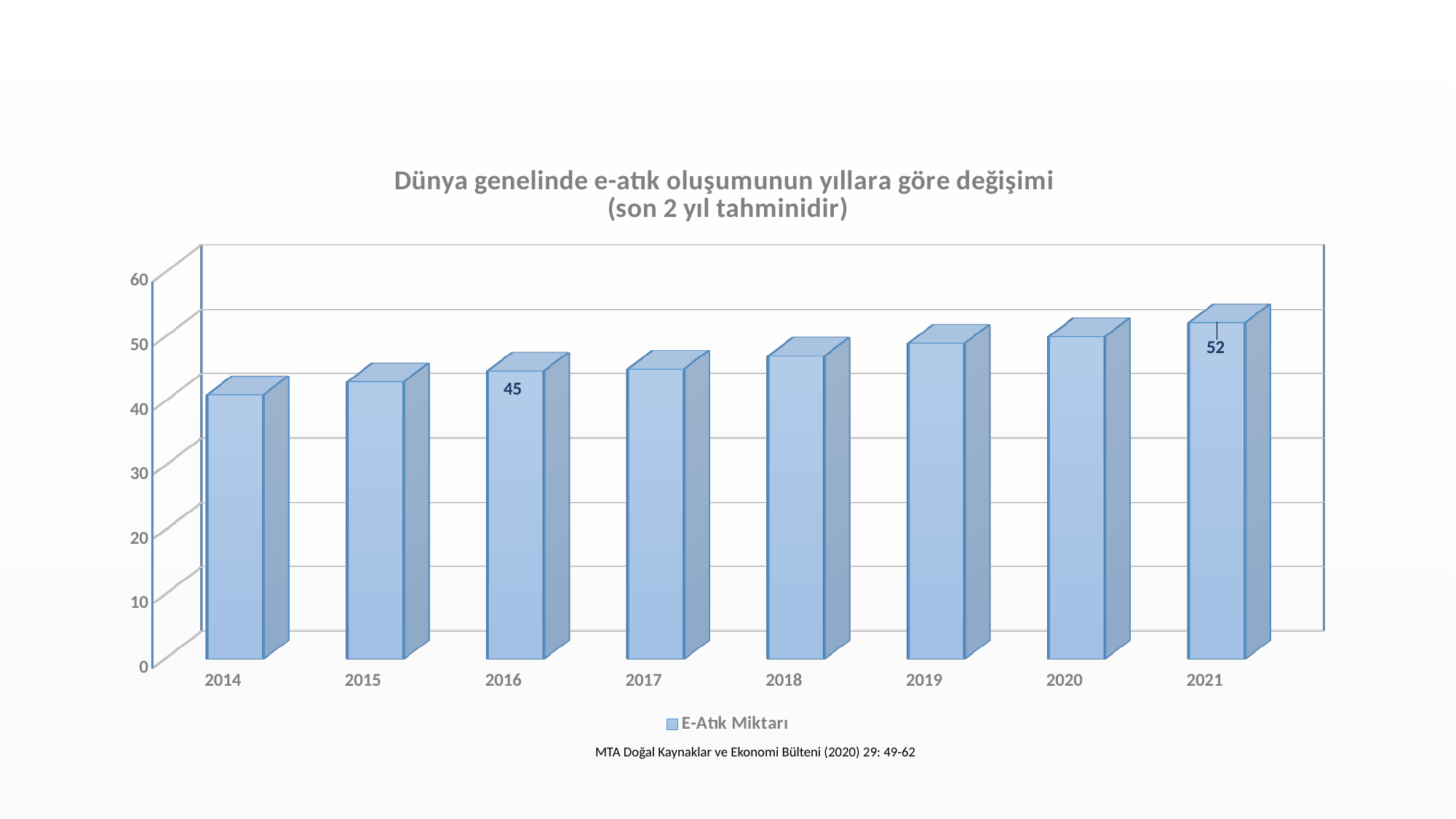
Do the values rise or fall from 2014 to 2021? rise Which is larger, the value for 2016 or the value for 2021? 2021 Is the value for 2018 greater or less than 40? greater What is the value for 2021? 52 What is the difference between the values for 2021 and 2016? 7 Is the value for 2015 greater or less than 50? less How many years are shown on the x axis? 8 What kind of chart is this? bar chart What is the value for 2016? 45 Which year has the lowest value? 2014 How many series does the legend list? 1 Which year has the highest value? 2021